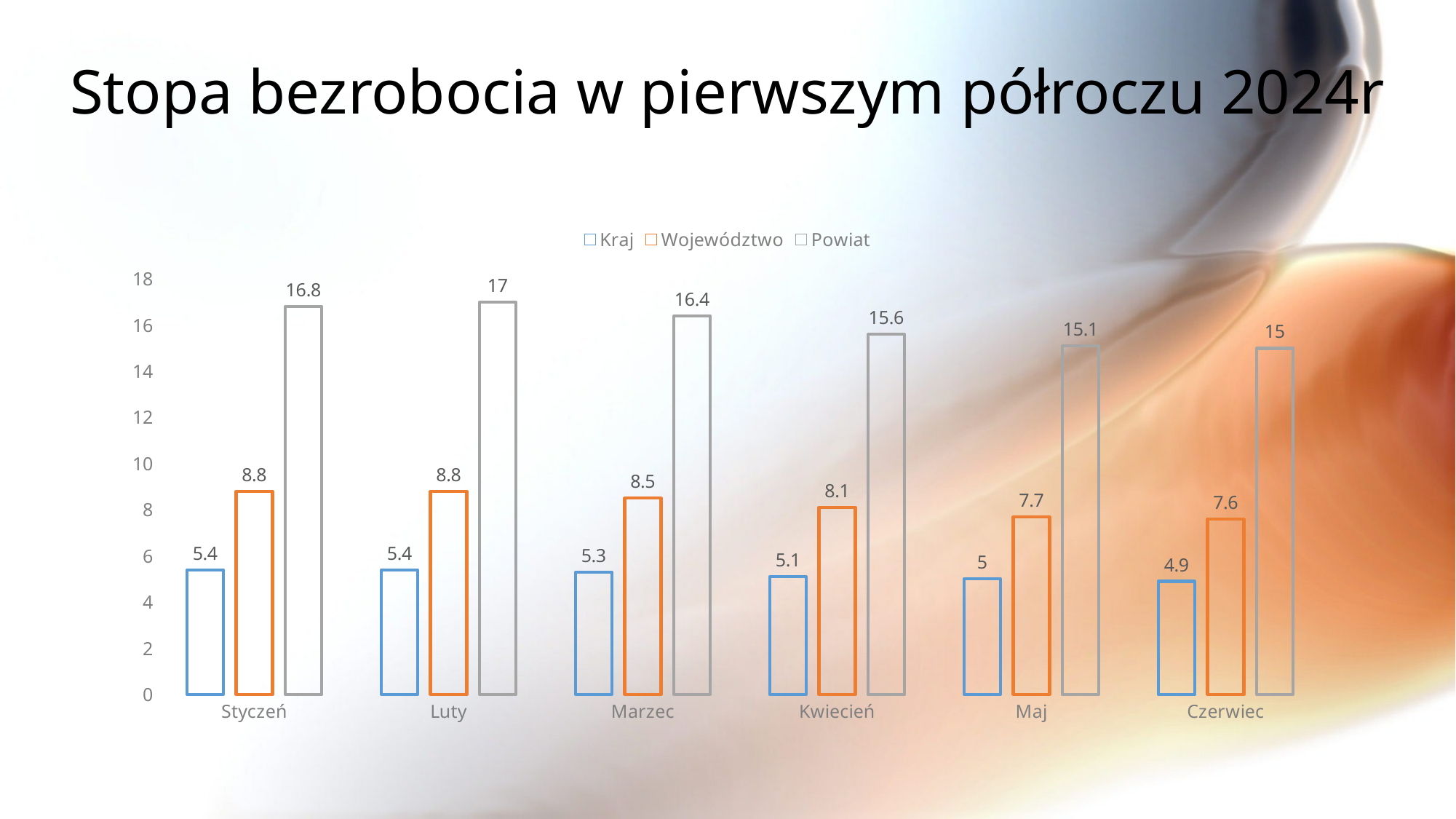
In which month is the Powiat value highest? Luty What kind of chart is shown on the slide? Bar chart What is the difference between the Powiat and Kraj values in Styczeń? 11.4 What is the value for Województwo in Kwiecień? 8.1 Does the Powiat value rise or fall from Marzec to Czerwiec? Fall What is the title of the slide? Stopa bezrobocia w pierwszym półroczu 2024r What is the value for Kraj in Czerwiec? 4.9 How many months are shown on the x axis? 6 What is the value for Powiat in Luty? 17 How many series does the legend list? 3 In which month is the Kraj value lowest? Czerwiec Which is larger: the Województwo value in Marzec or in Maj? Marzec